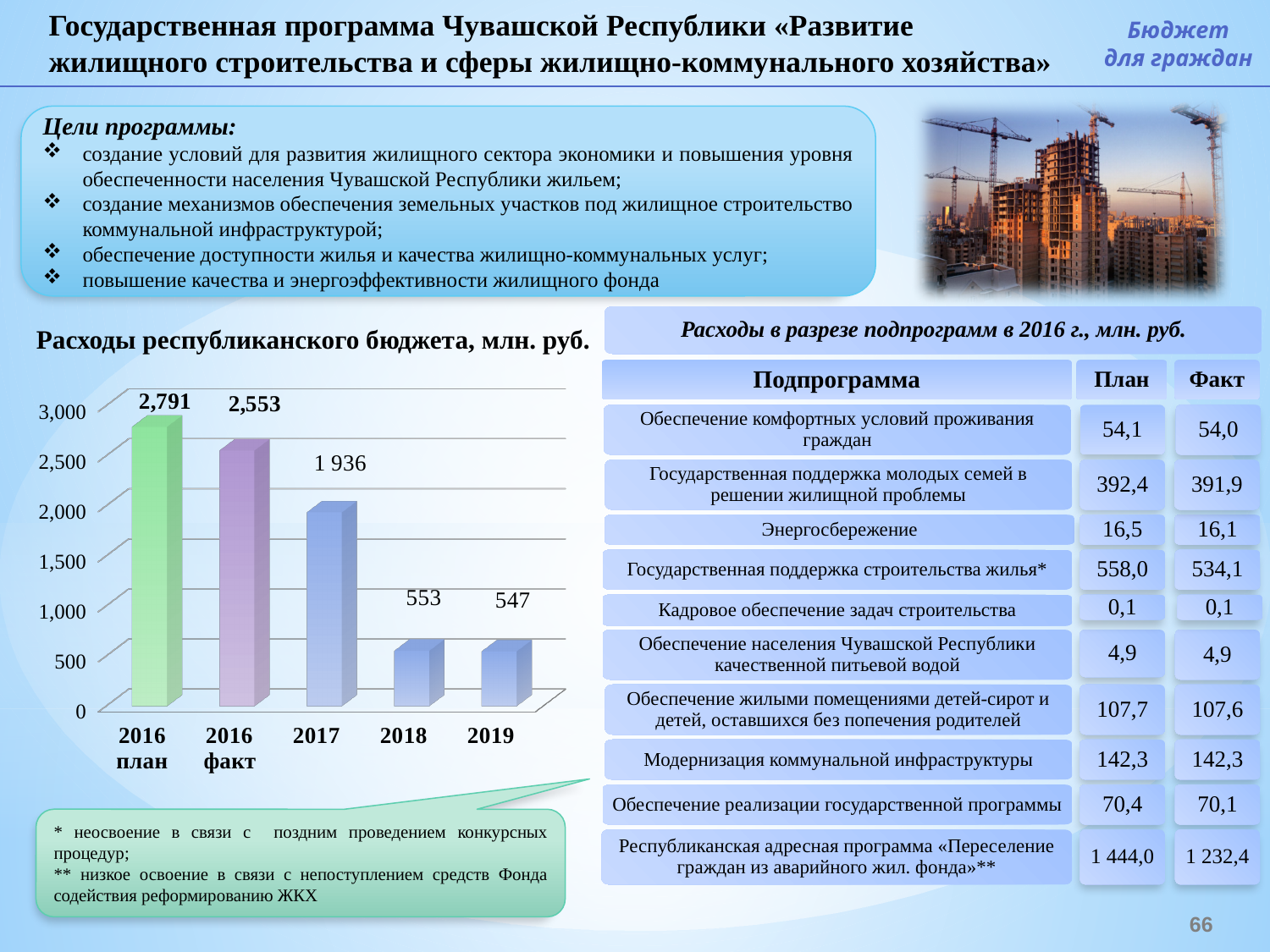
What is the difference between the 2016 план and 2016 факт values in the chart 'Расходы республиканского бюджета, млн. руб.'? 238 Is the value for 2017 in the chart 'Расходы республиканского бюджета, млн. руб.' greater or less than 1,500? greater What is the value for 2016 план in the chart 'Расходы республиканского бюджета, млн. руб.'? 2,791 What is the value for 2019 in the chart 'Расходы республиканского бюджета, млн. руб.'? 547 Which category has the lowest value in the chart 'Расходы республиканского бюджета, млн. руб.'? 2019 In the chart 'Расходы республиканского бюджета, млн. руб.', which is larger: the value for 2016 факт or the value for 2017? 2016 факт Which category has the highest value in the chart 'Расходы республиканского бюджета, млн. руб.'? 2016 план What is the value for 2017 in the chart 'Расходы республиканского бюджета, млн. руб.'? 1 936 What is the value for 2016 факт in the chart 'Расходы республиканского бюджета, млн. руб.'? 2,553 What is the difference between the 2018 and 2019 values in the chart 'Расходы республиканского бюджета, млн. руб.'? 6 What type of chart is 'Расходы республиканского бюджета, млн. руб.'? bar chart How many bars are shown in the chart 'Расходы республиканского бюджета, млн. руб.'? 5